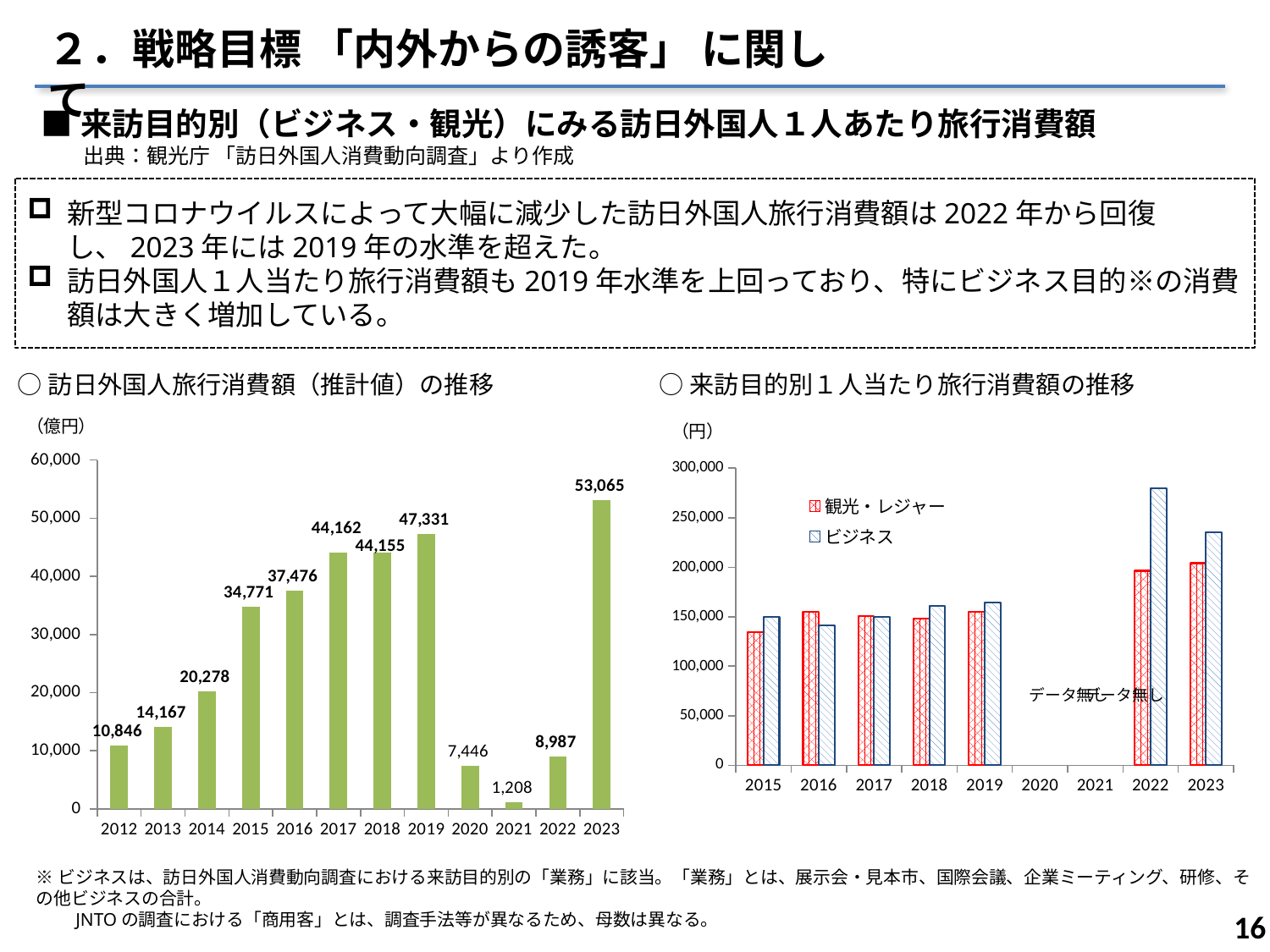
In the left chart (訪日外国人旅行消費額（推計値）の推移), how many years are plotted? 12 In the left chart (訪日外国人旅行消費額（推計値）の推移), which year has the lowest value? 2021 In the right chart (来訪目的別１人当たり旅行消費額の推移), which series has the higher value in 2023, 観光・レジャー or ビジネス? ビジネス In the right chart (来訪目的別１人当たり旅行消費額の推移), how many series does the legend list? 2 In the left chart (訪日外国人旅行消費額（推計値）の推移), what is the value for 2021? 1,208 In the left chart (訪日外国人旅行消費額（推計値）の推移), what is the value for 2023? 53,065 In the left chart (訪日外国人旅行消費額（推計値）の推移), which year has the highest value? 2023 In the left chart (訪日外国人旅行消費額（推計値）の推移), what unit is shown above the vertical axis? 億円 In the left chart (訪日外国人旅行消費額（推計値）の推移), which is larger, the value for 2017 or the value for 2018? 2017 In the left chart (訪日外国人旅行消費額（推計値）の推移), what is the difference between the 2023 value and the 2019 value? 5,734 In the right chart (来訪目的別１人当たり旅行消費額の推移), is the ビジネス value for 2022 greater or less than 250,000? greater What kind of chart is the right chart (来訪目的別１人当たり旅行消費額の推移)? Bar chart